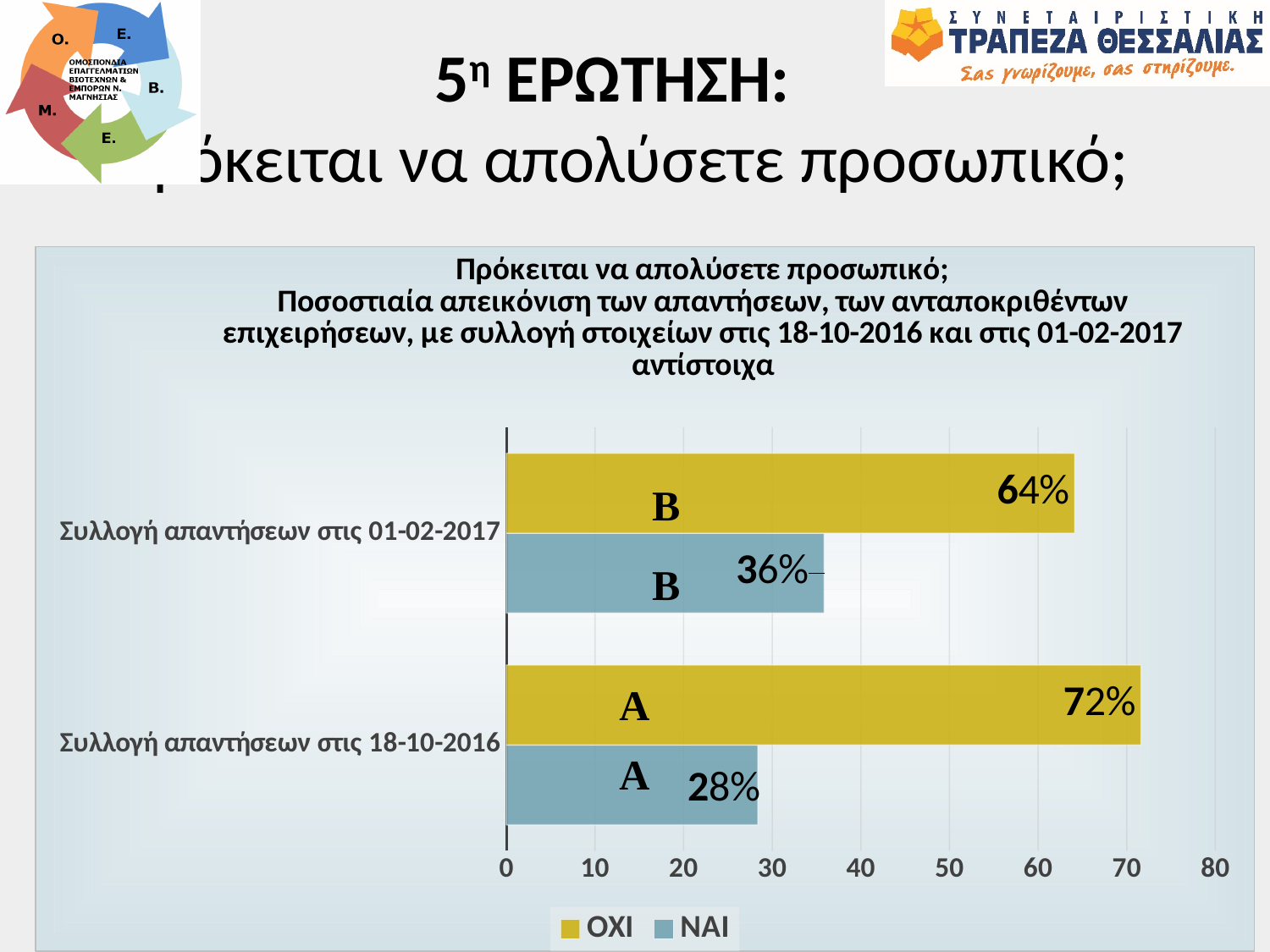
Which category has the higher ΟΧΙ value? Συλλογή απαντήσεων στις 18-10-2016 What is the difference between the ΟΧΙ values for 18-10-2016 and 01-02-2017? 8% What type of chart is shown on the slide? bar chart What is the ΟΧΙ value for Συλλογή απαντήσεων στις 01-02-2017? 64% How many series does the legend list? 2 Which colour represents the ΝΑΙ series? blue What is the ΝΑΙ value for Συλλογή απαντήσεων στις 01-02-2017? 36% Which category has the lower ΝΑΙ value? Συλλογή απαντήσεων στις 18-10-2016 What is the ΟΧΙ value for Συλλογή απαντήσεων στις 18-10-2016? 72% How many categories are shown on the chart? 2 Is the ΝΑΙ value for Συλλογή απαντήσεων στις 01-02-2017 larger or smaller than the ΝΑΙ value for Συλλογή απαντήσεων στις 18-10-2016? larger What is the ΝΑΙ value for Συλλογή απαντήσεων στις 18-10-2016? 28%